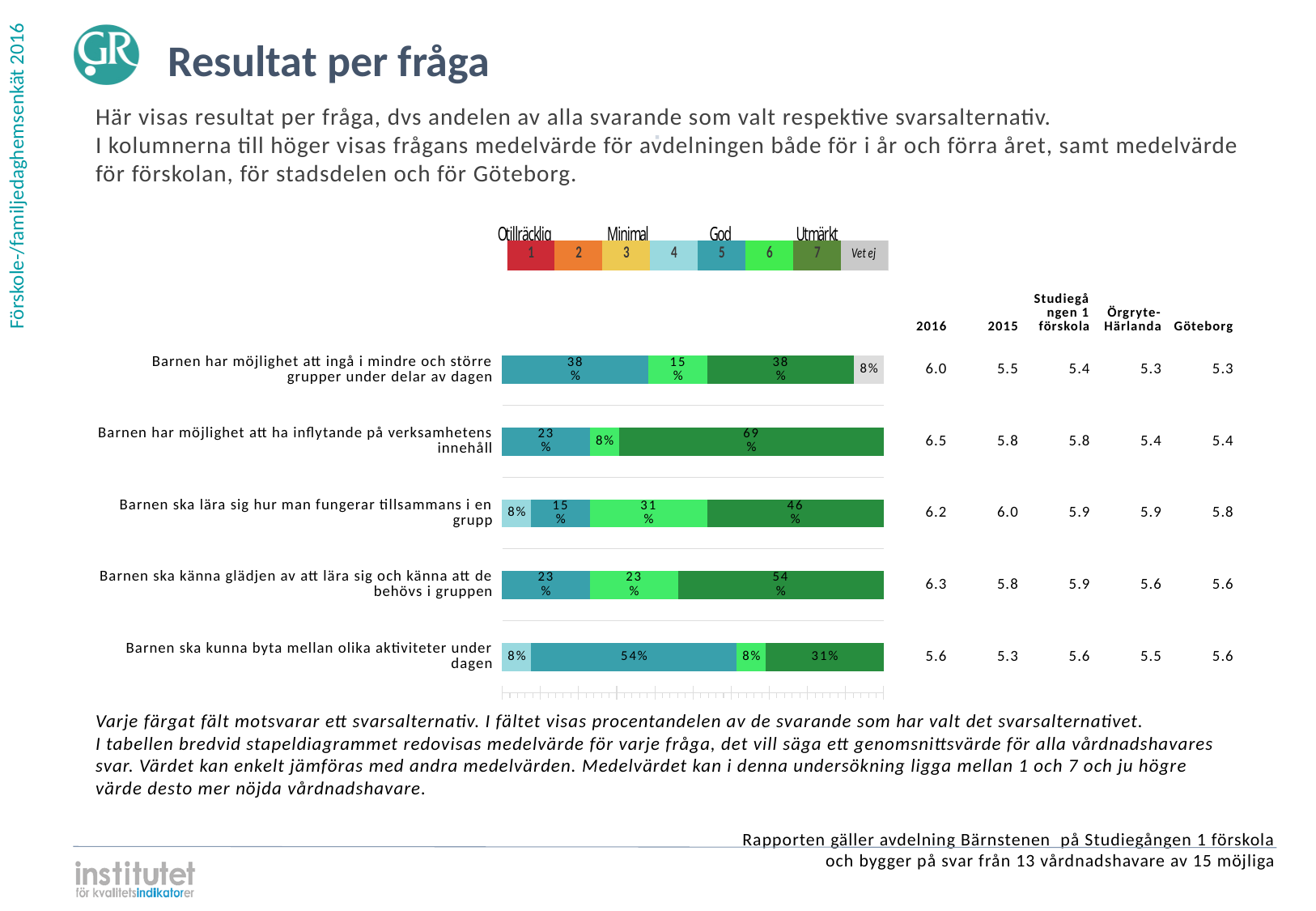
What is the 2016 mean value shown for 'Barnen har möjlighet att ha inflytande på verksamhetens innehåll'? 6.5 What is the title of the slide? Resultat per fråga How many response categories does the colour legend above the chart list, including 'Vet ej'? 8 What is the largest segment in the bar for 'Barnen ska kunna byta mellan olika aktiviteter under dagen'? 54% How many questions (bars) are shown in the chart? 5 What is the difference between the '7' share for 'Barnen ska känna glädjen av att lära sig och känna att de behövs i gruppen' (54%) and for 'Barnen ska lära sig hur man fungerar tillsammans i en grupp' (46%)? 8% What percentage chose 'Vet ej' for 'Barnen har möjlighet att ingå i mindre och större grupper under delar av dagen'? 8% Which is larger: the light green '6' share for 'Barnen ska lära sig hur man fungerar tillsammans i en grupp' or for 'Barnen ska känna glädjen av att lära sig och känna att de behövs i gruppen'? Barnen ska lära sig hur man fungerar tillsammans i en grupp Which question has the lowest share of respondents choosing the dark green '7' option? Barnen ska kunna byta mellan olika aktiviteter under dagen What kind of chart is used to show the results per question? Stacked bar chart What percentage of respondents chose the dark green '7' (Utmärkt) option for 'Barnen har möjlighet att ha inflytande på verksamhetens innehåll'? 69% Which question has the highest share of respondents choosing the dark green '7' option? Barnen har möjlighet att ha inflytande på verksamhetens innehåll